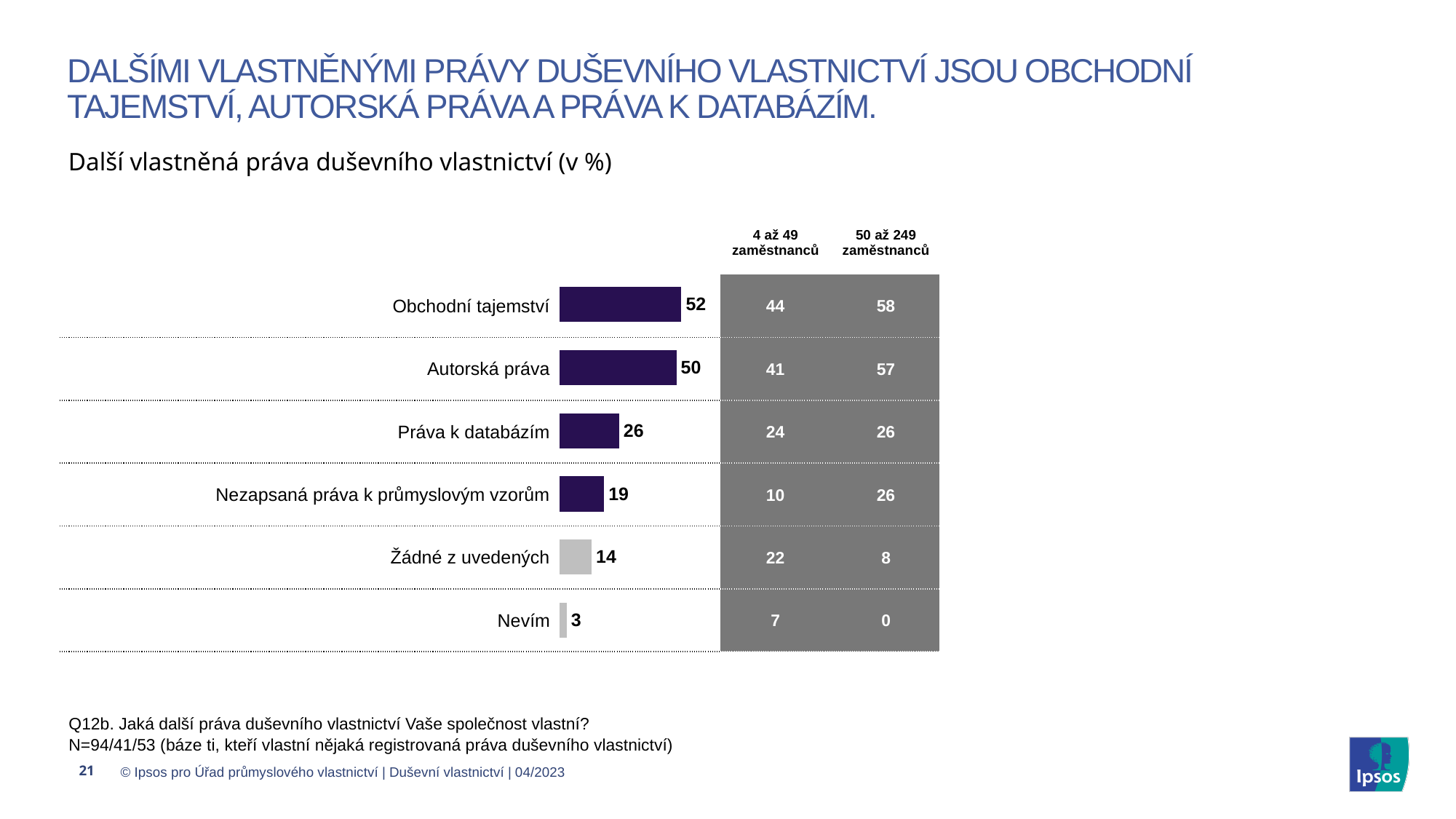
What is the value for Obchodní tajemství in the bar chart? 52 In the table next to the chart, what is the value for Autorská práva among companies with 50 až 249 zaměstnanců? 57 What is the value for Žádné z uvedených in the bar chart? 14 Which category has the lowest value in the bar chart? Nevím What is the difference between the values for Obchodní tajemství and Práva k databázím in the bar chart? 26 What kind of chart is shown on the slide? Bar chart What is the subtitle of the chart on the slide? Další vlastněná práva duševního vlastnictví (v %) In the table next to the chart, what is the value for Žádné z uvedených among companies with 4 až 49 zaměstnanců? 22 Which category has the highest value in the bar chart? Obchodní tajemství What is the value for Nezapsaná práva k průmyslovým vzorům in the bar chart? 19 How many categories are shown in the bar chart? 6 Which has a larger value in the bar chart, Práva k databázím or Žádné z uvedených? Práva k databázím